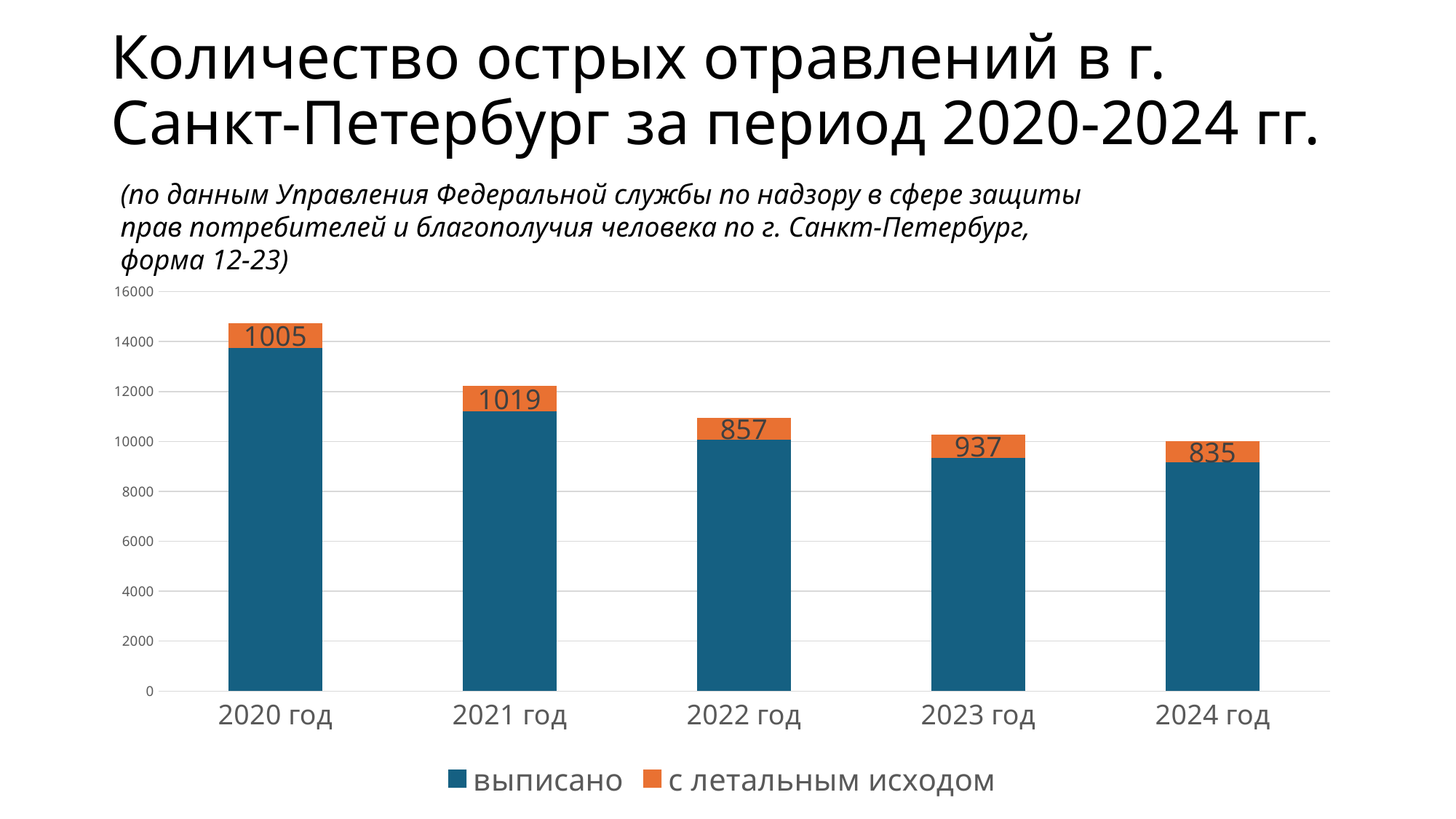
Is the value for "выписано" in 2020 год greater or less than 12000? greater Which year has the lowest value for "с летальным исходом"? 2024 год How many years are shown on the x axis? 5 How many series does the legend list? 2 What is the value for "с летальным исходом" in 2022 год? 857 What kind of chart is shown on the slide? Stacked bar chart Which is larger, the "с летальным исходом" value for 2022 год or for 2023 год? 2023 год Which year has the highest value for "с летальным исходом"? 2021 год What is the value for "с летальным исходом" in 2024 год? 835 Is the value for "выписано" in 2024 год greater or less than 10000? less What is the difference between the "с летальным исходом" values for 2021 год and 2023 год? 82 What is the value for "с летальным исходом" in 2020 год? 1005